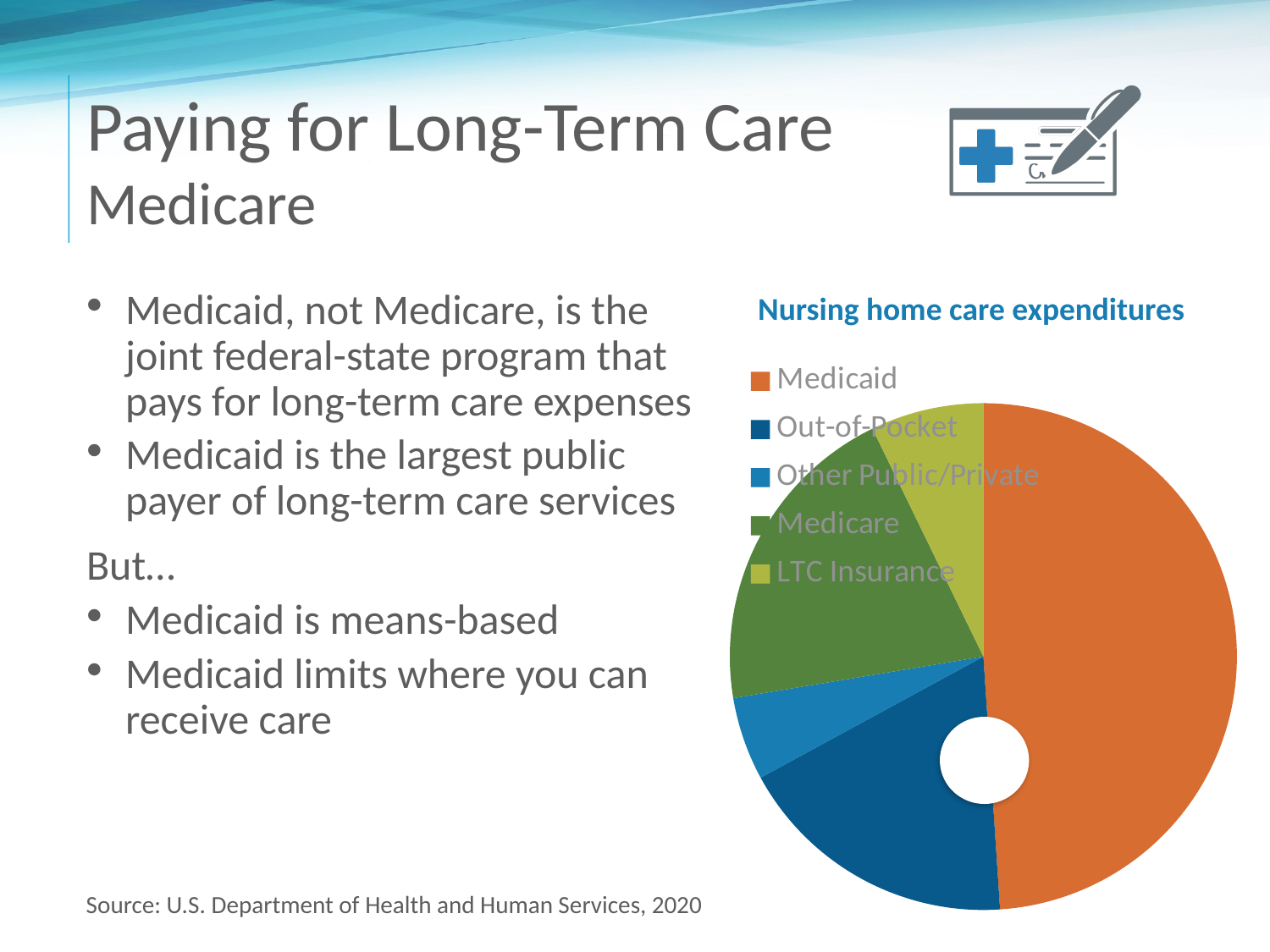
Which is larger, the share for Medicaid or the share for Out-of-Pocket? Medicaid What is the title of the chart? Nursing home care expenditures What colour is the Medicaid slice in the pie chart? orange How many slices does the pie chart have? 5 How many entries does the chart's legend list? 5 Which category has the largest share of nursing home care expenditures? Medicaid What kind of chart is shown on the slide? pie chart Which is larger, the share for Medicaid or the share for Medicare? Medicaid Which is larger, the share for Medicare or the share for Other Public/Private? Medicare